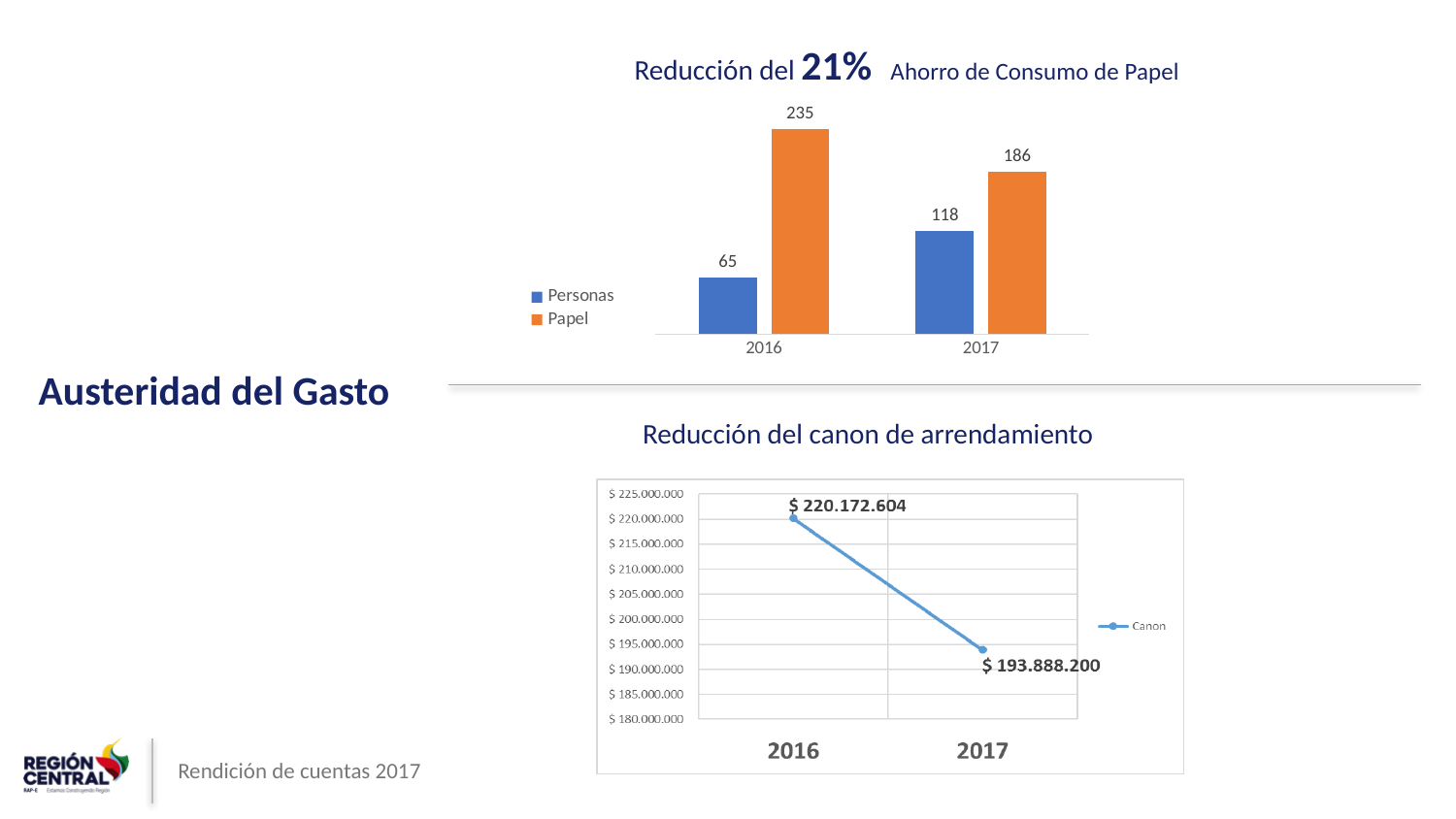
What kind of chart is the bottom chart (Reducción del canon de arrendamiento)? line chart In the top chart (Ahorro de Consumo de Papel), which series has the higher value in 2017, Personas or Papel? Papel In the top chart (Ahorro de Consumo de Papel), does the Papel value rise or fall from 2016 to 2017? fall In the bottom chart (Reducción del canon de arrendamiento), what is the Canon value for 2017? $ 193.888.200 In the bottom chart (Reducción del canon de arrendamiento), how many data points are plotted? 2 In the top chart (Ahorro de Consumo de Papel), how many series does the legend list? 2 In the bottom chart (Reducción del canon de arrendamiento), what is the Canon value for 2016? $ 220.172.604 In the top chart (Ahorro de Consumo de Papel), what is the difference between the Papel values for 2016 and 2017? 49 In the top chart (Ahorro de Consumo de Papel), what colour are the Papel bars? orange In the top chart (Ahorro de Consumo de Papel), what is the value for Personas in 2017? 118 In the top chart (Ahorro de Consumo de Papel), what is the value for Papel in 2016? 235 What kind of chart is the top chart (Ahorro de Consumo de Papel)? bar chart